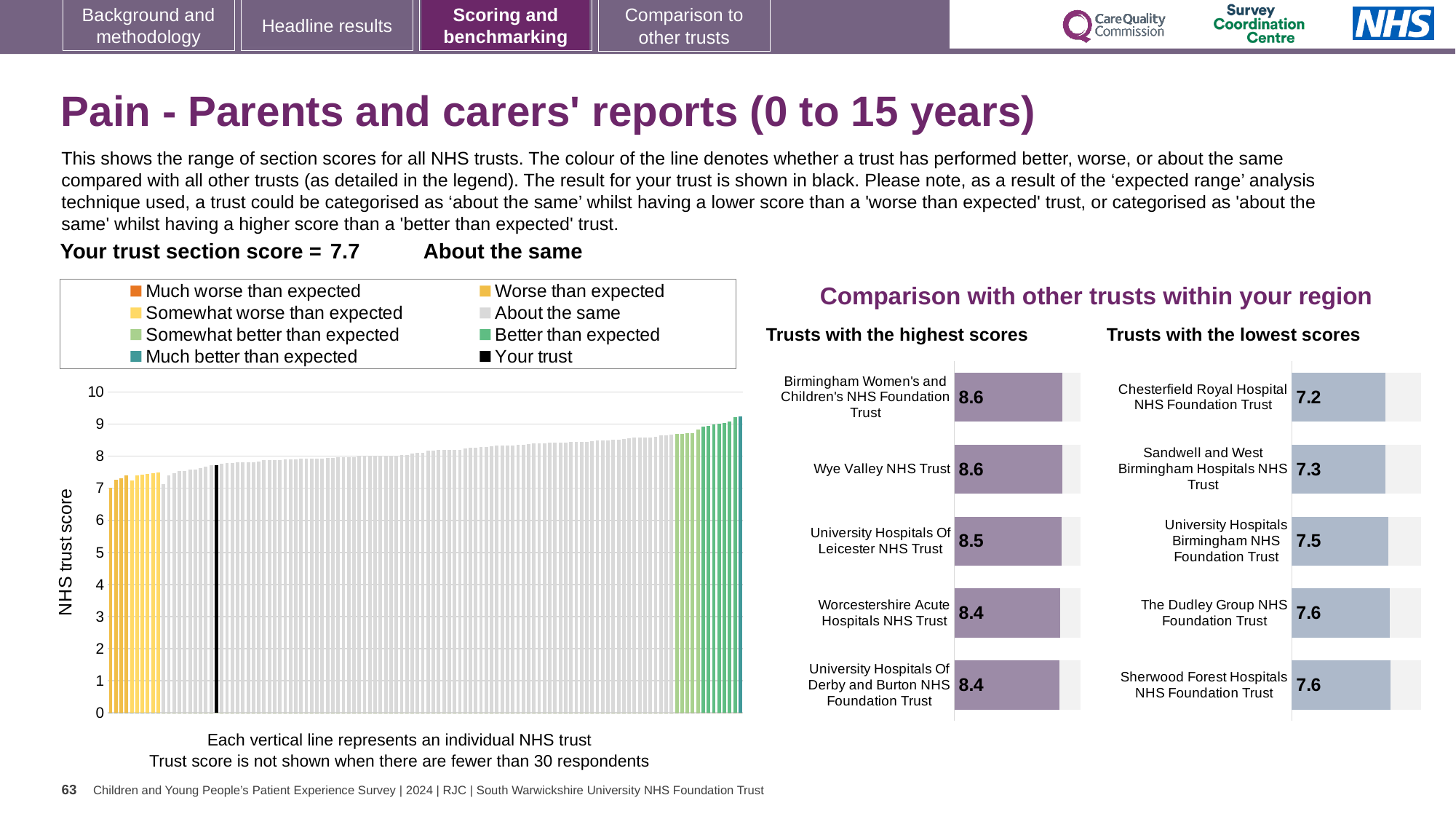
In the 'Trusts with the highest scores' chart, what is the difference between the scores of Wye Valley NHS Trust and University Hospitals Of Derby and Burton NHS Foundation Trust? 0.2 In the 'Trusts with the lowest scores' chart, which has the higher score: Chesterfield Royal Hospital NHS Foundation Trust or University Hospitals Birmingham NHS Foundation Trust? University Hospitals Birmingham NHS Foundation Trust In the large chart on the left, do the trust scores rise or fall from left to right? Rise How many trusts are listed in the 'Trusts with the highest scores' chart? 5 In the 'Trusts with the lowest scores' chart, what is the score for Sandwell and West Birmingham Hospitals NHS Trust? 7.3 In the 'Trusts with the highest scores' chart, what is the score for University Hospitals Of Leicester NHS Trust? 8.5 How many entries does the legend of the large chart on the left list? 8 What kind of chart is the large chart on the left showing NHS trust scores? Bar chart In the large chart on the left, is the value for the black 'Your trust' bar greater or less than 8? less In the 'Trusts with the lowest scores' chart, which trust has the lowest score? Chesterfield Royal Hospital NHS Foundation Trust In the 'Trusts with the highest scores' chart, what is the score for Wye Valley NHS Trust? 8.6 In the 'Trusts with the lowest scores' chart, what is the difference between the scores of Sherwood Forest Hospitals NHS Foundation Trust and Chesterfield Royal Hospital NHS Foundation Trust? 0.4